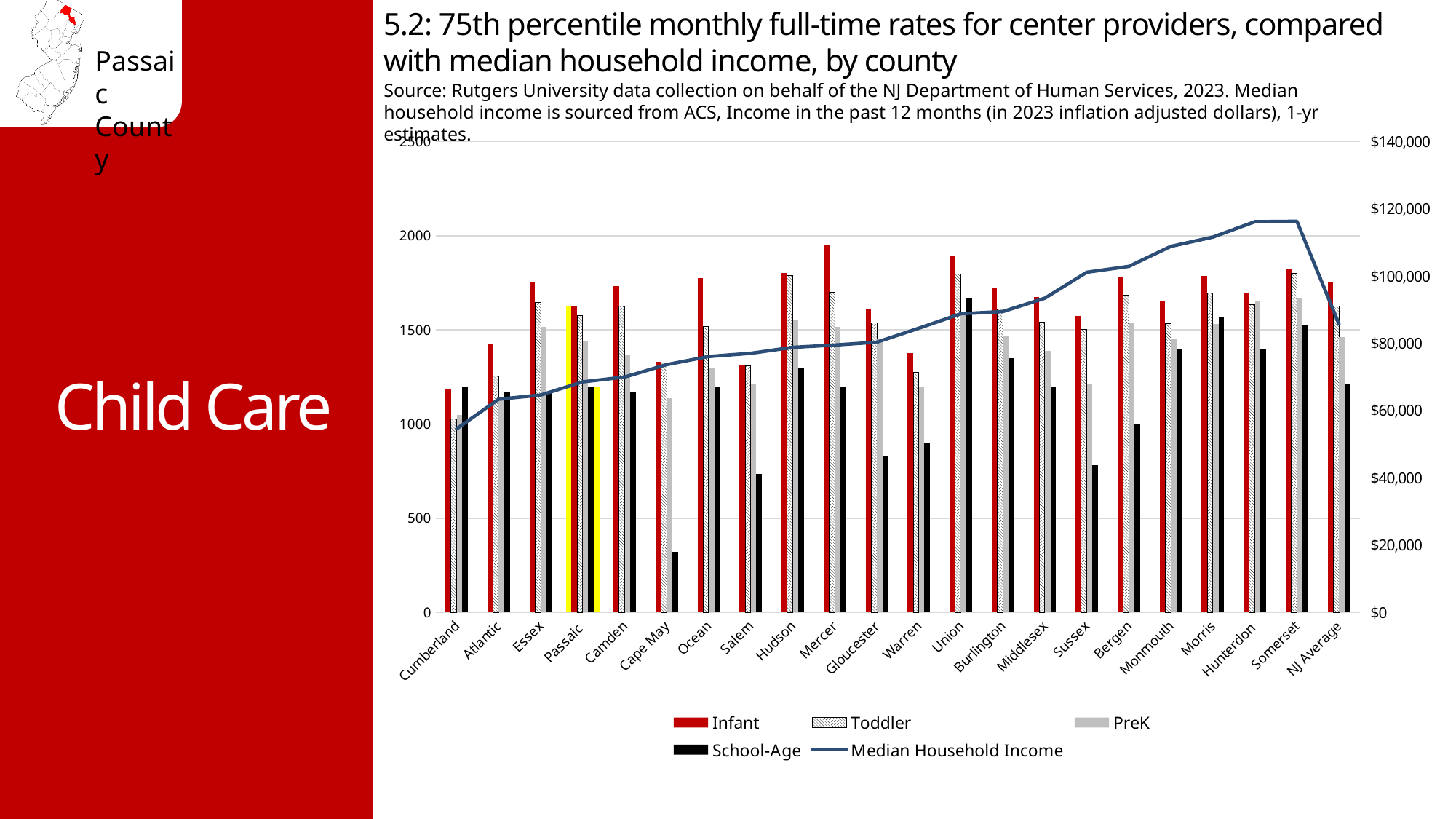
Is the School-Age rate for Cape May greater or less than 500? less Which county has the lowest School-Age rate? Cape May How many series does the chart legend list? 5 What kind of chart is this? Bar chart with a line Which is larger, the School-Age rate for Union or for Warren? Union Is the Median Household Income for Somerset greater or less than $100,000? greater Which county has the highest Infant rate? Mercer How many counties/categories are shown on the x axis of the chart? 22 Which county's bars are highlighted in yellow on the chart? Passaic Does the Median Household Income line generally rise or fall from Cumberland to Somerset? rise Which county has the lowest Infant rate? Cumberland Is the Infant rate for Cumberland greater or less than 1000? greater